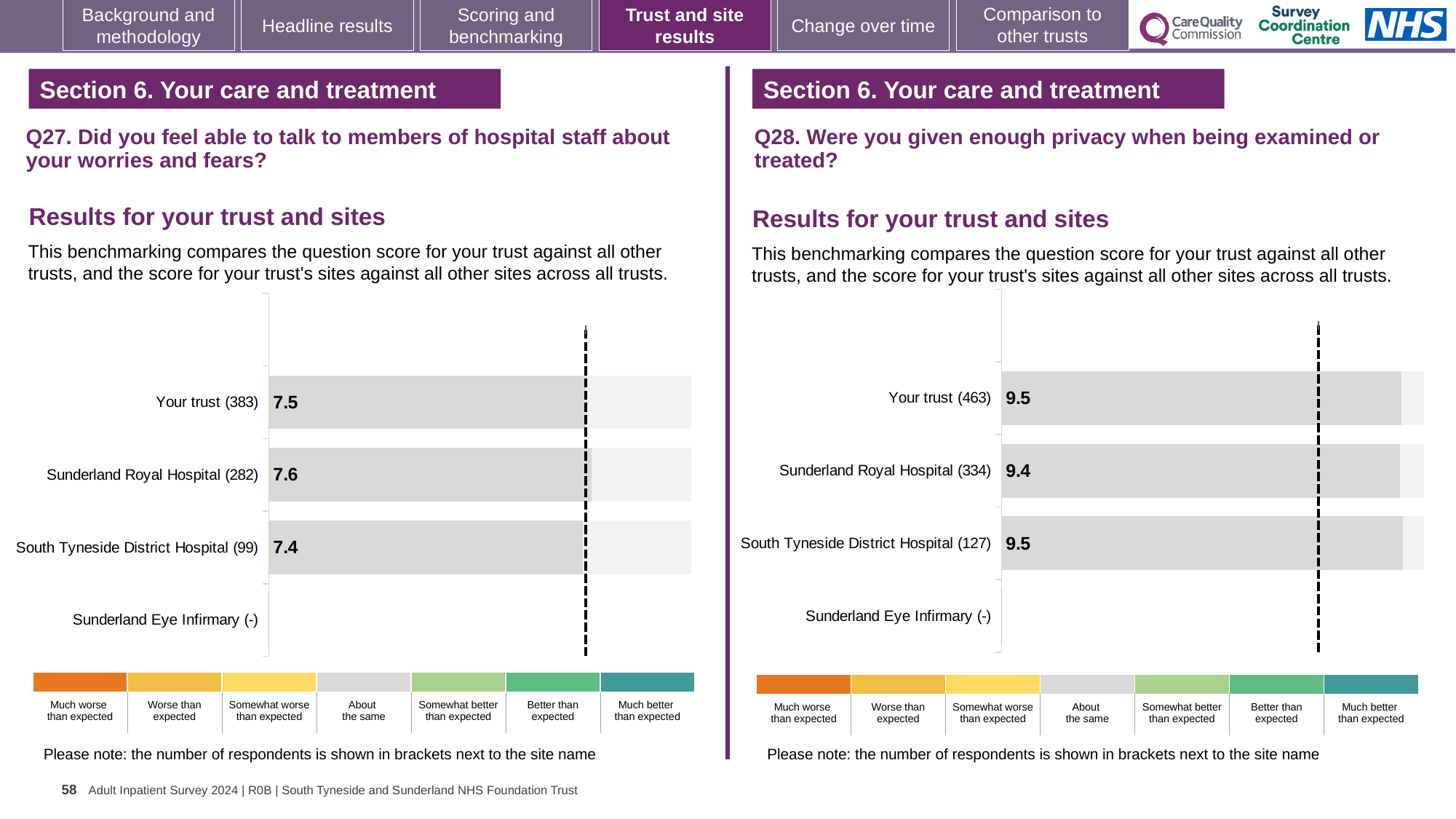
In the Q27 chart on the left, what is the score for Sunderland Royal Hospital? 7.6 In the Q27 chart on the left, what is the difference between the scores for Sunderland Royal Hospital and South Tyneside District Hospital? 0.2 In the Q27 chart on the left, which site has the lowest score? South Tyneside District Hospital What kind of chart is used in the Q28 chart on the right? Bar chart In the Q28 chart on the right, what is the score for Sunderland Royal Hospital? 9.4 In the Q27 chart on the left, what is the score for South Tyneside District Hospital? 7.4 In the Q28 chart on the right, what is the score for Your trust? 9.5 In the Q27 chart on the left, what is the score for Your trust? 7.5 In the Q27 chart on the left, which site has the highest score? Sunderland Royal Hospital In the Q28 chart on the right, what is the difference between the scores for South Tyneside District Hospital and Sunderland Royal Hospital? 0.1 In the Q28 chart on the right, which has the larger score, Your trust or Sunderland Royal Hospital? Your trust How many rows (sites including Your trust) are listed in the Q27 chart on the left? 4